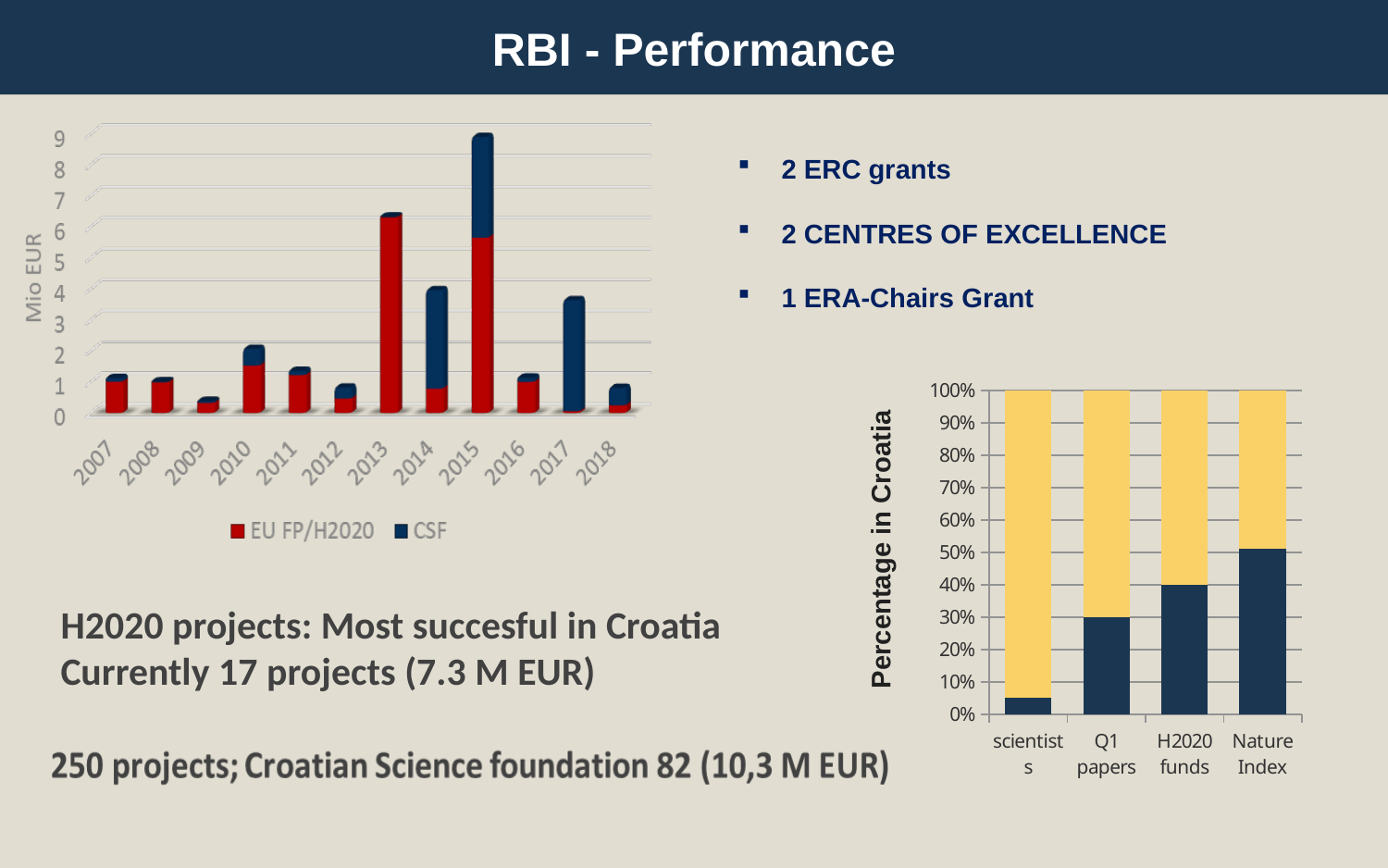
In the left chart (Mio EUR by year), what are the two legend entries? EU FP/H2020 and CSF In the left chart (Mio EUR by year), is the total value for 2009 greater or less than 1? less In the left chart (Mio EUR by year), which year has the highest total bar? 2015 In the left chart (Mio EUR by year), how many series does the legend list? 2 What kind of chart is the left chart showing Mio EUR by year? stacked bar chart In the right chart (Percentage in Croatia), which category has the largest dark blue portion? Nature Index In the left chart (Mio EUR by year), how many years are shown on the x axis? 12 In the right chart (Percentage in Croatia), is the dark blue portion for scientists greater or less than 10%? less In the right chart (Percentage in Croatia), which category has the smallest dark blue portion? scientists In the right chart (Percentage in Croatia), how many categories are shown on the x axis? 4 In the left chart (Mio EUR by year), is the total value for 2013 greater or less than 5? greater In the left chart (Mio EUR by year), what is the label on the vertical axis? Mio EUR